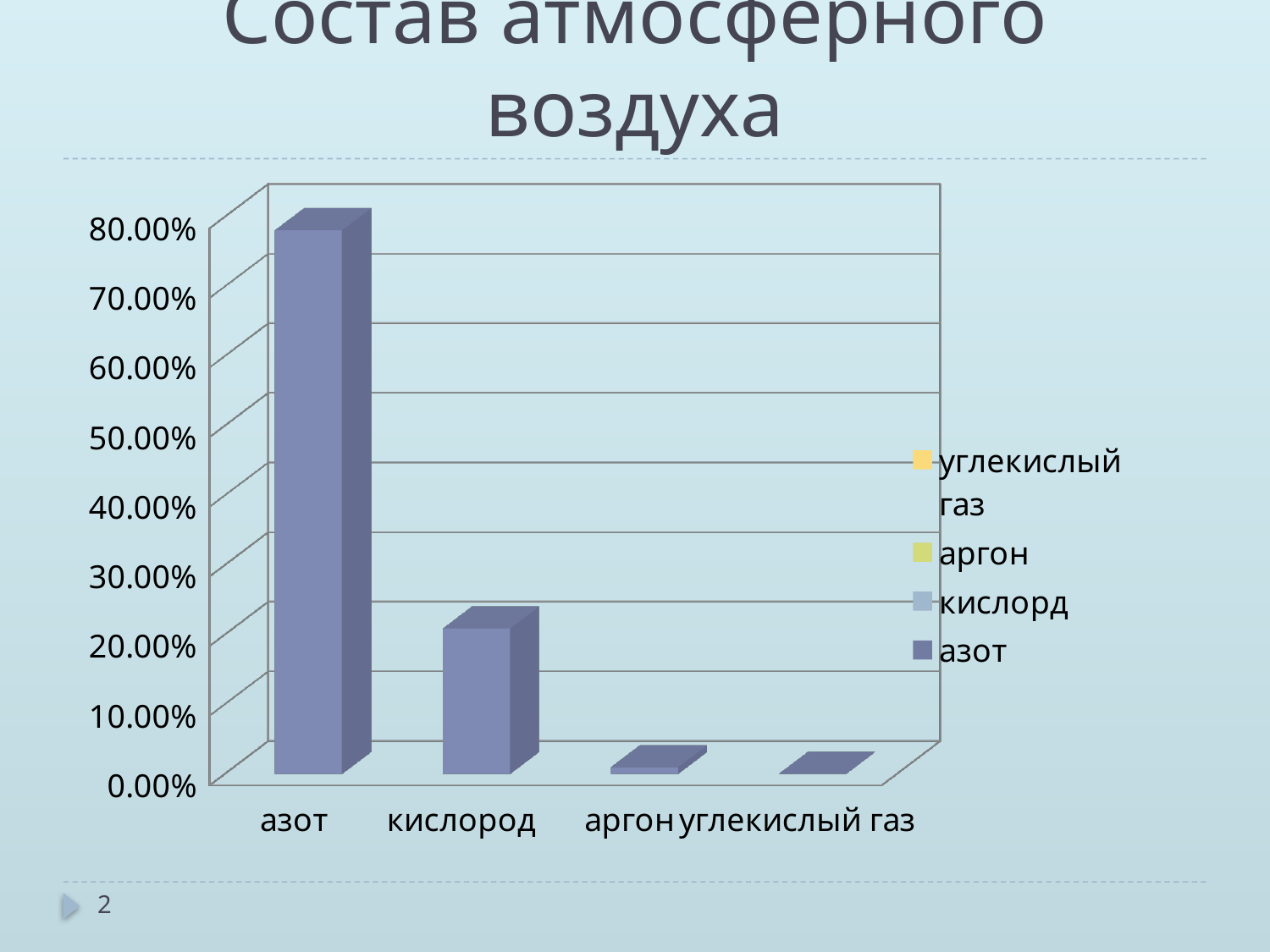
How many entries does the legend list? 4 Is the value for кислород greater or less than 10.00%? greater How many categories are shown on the x axis? 4 Is the value for азот greater or less than 70.00%? greater Do the bar values rise or fall from left to right along the x axis? fall Which is larger, the value for азот or the value for кислород? азот Is the value for аргон greater or less than 10.00%? less What is the title of the chart? Состав атмосферного воздуха Which category has the highest bar? азот What kind of chart is shown on the slide? bar chart